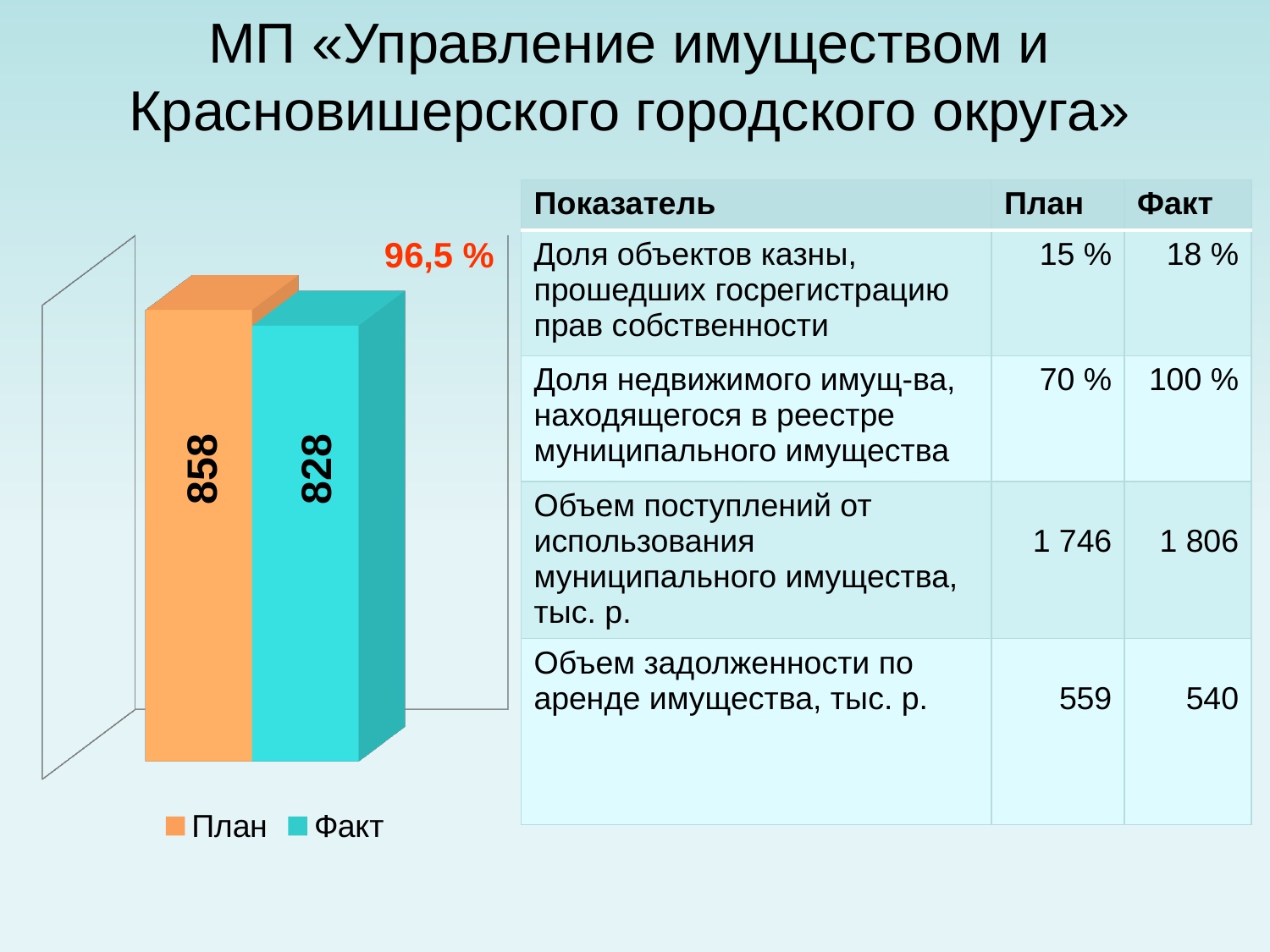
What value is shown for Факт in the bar chart? 828 Which bar in the chart is the highest? План How many bars are plotted in the chart? 2 What colour is the Факт bar in the chart? teal Which bar in the chart is the lowest? Факт What percentage is printed in red above the bar chart? 96,5 % Which series has the higher value in the bar chart, План or Факт? План How many series does the chart legend list? 2 What is the difference between the План and Факт values in the bar chart? 30 What kind of chart is shown on the slide? bar chart What value is shown for План in the bar chart? 858